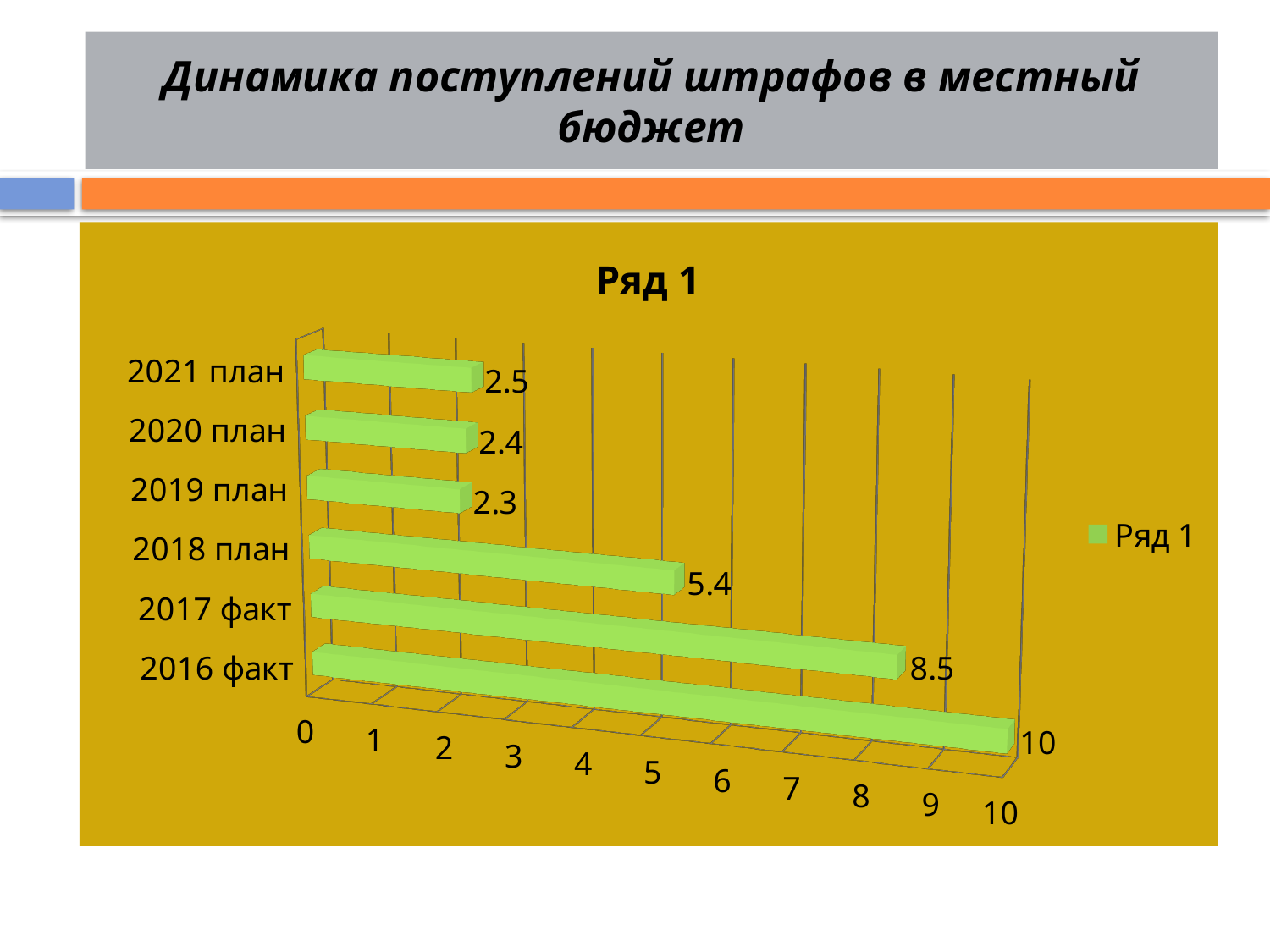
Which category has the highest value? 2016 факт Which is larger, the value for 2017 факт or the value for 2018 план? 2017 факт How many series does the legend list? 1 Which category has the lowest value? 2019 план What is the difference between the values for 2016 факт and 2017 факт? 1.5 What is the value for 2016 факт? 10 What is the value for 2018 план? 5.4 What is the difference between the values for 2018 план and 2019 план? 3.1 What is the value for 2021 план? 2.5 Is the value for 2017 факт greater or less than 8? greater What kind of chart is shown on the slide? bar chart How many categories are shown in the chart? 6